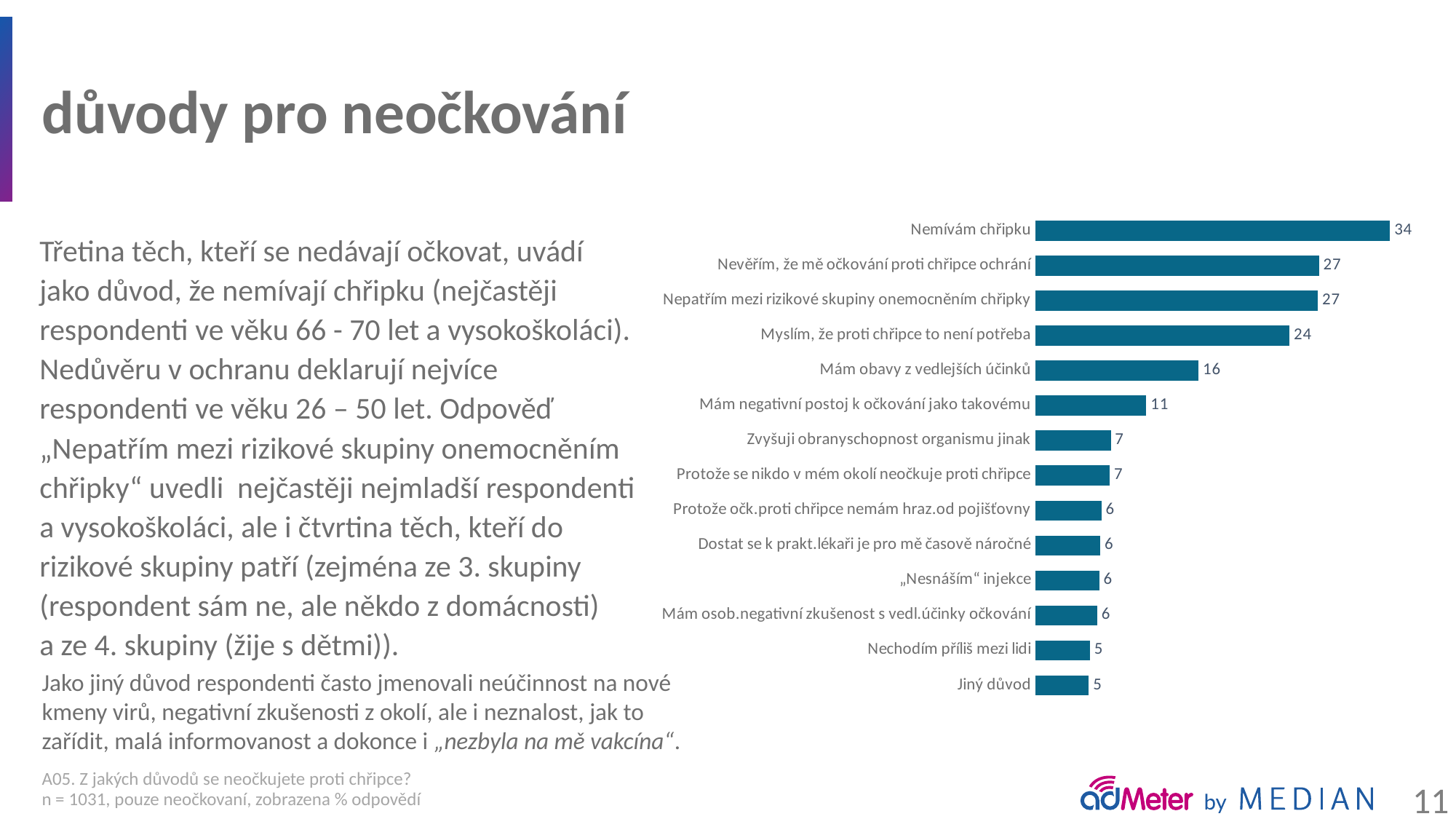
What is the difference between the values for "Nemívám chřipku" and "Myslím, že proti chřipce to není potřeba"? 10 What is the value for "Mám negativní postoj k očkování jako takovému"? 11 Which is larger: the value for "Myslím, že proti chřipce to není potřeba" or the value for "Mám obavy z vedlejších účinků"? Myslím, že proti chřipce to není potřeba What is the value for "Nevěřím, že mě očkování proti chřipce ochrání"? 27 What is the value for "Zvyšuji obranyschopnost organismu jinak"? 7 What is the value for "Jiný důvod"? 5 What is the value for "Nemívám chřipku"? 34 What is the difference between the values for "Mám obavy z vedlejších účinků" and "Mám negativní postoj k očkování jako takovému"? 5 What is the value for "Mám obavy z vedlejších účinků"? 16 Which category has the highest value? Nemívám chřipku How many categories are shown in the chart? 14 What kind of chart is shown on the slide? Bar chart